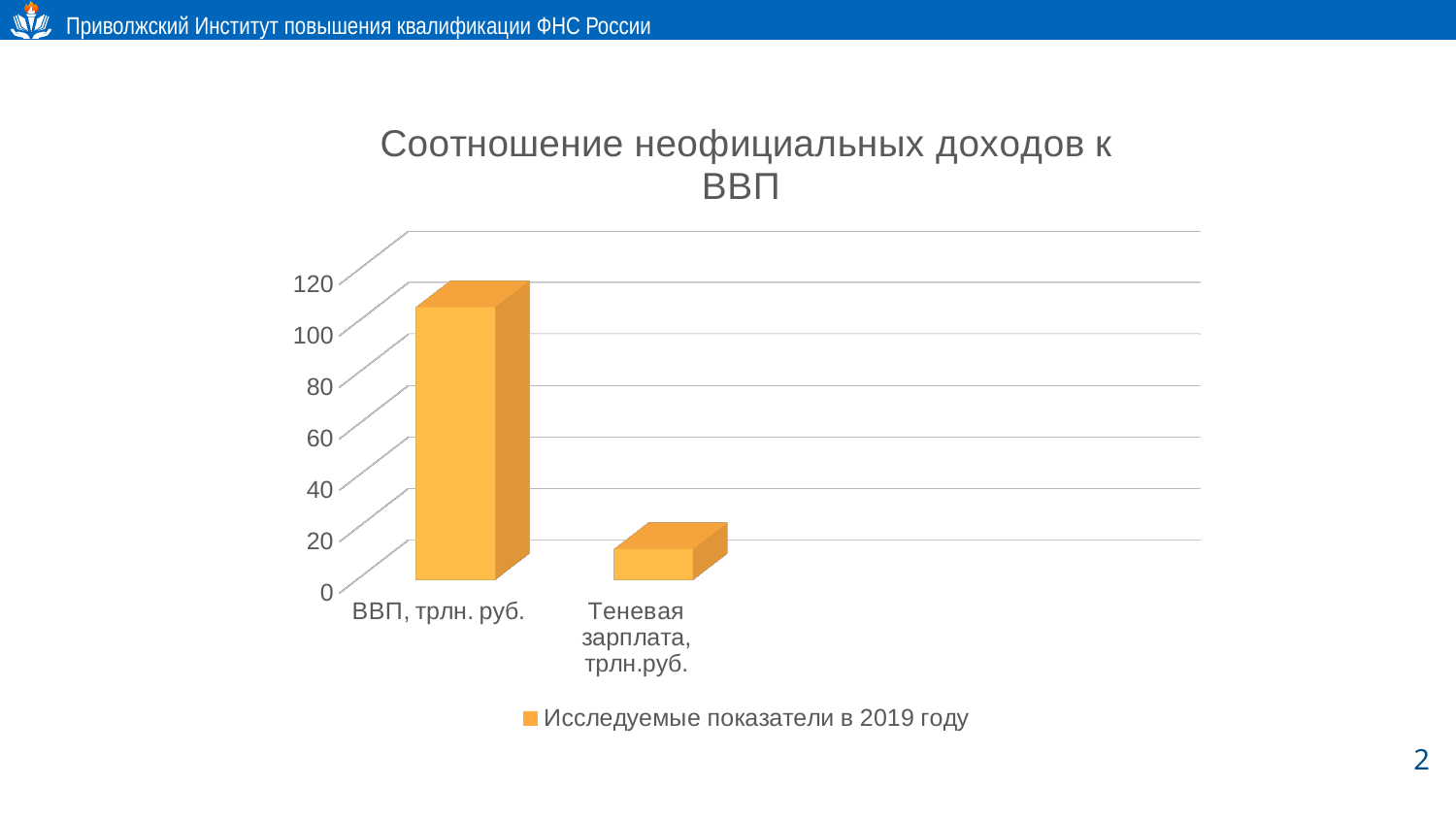
Which category has the lowest value? Теневая зарплата, трлн.руб. What is the legend entry of the chart? Исследуемые показатели в 2019 году Is the value for Теневая зарплата, трлн.руб. greater or less than 20? less What kind of chart is shown on the slide? bar chart Which category has the highest value? ВВП, трлн. руб. How many categories are plotted in the chart? 2 Is the value for ВВП, трлн. руб. greater or less than 100? greater What is the title of the chart? Соотношение неофициальных доходов к ВВП Do the values rise or fall from left to right along the x axis? fall Which is larger: the value for ВВП, трлн. руб. or the value for Теневая зарплата, трлн.руб.? ВВП, трлн. руб. Is the value for ВВП, трлн. руб. greater or less than 120? less How many series does the legend list? 1